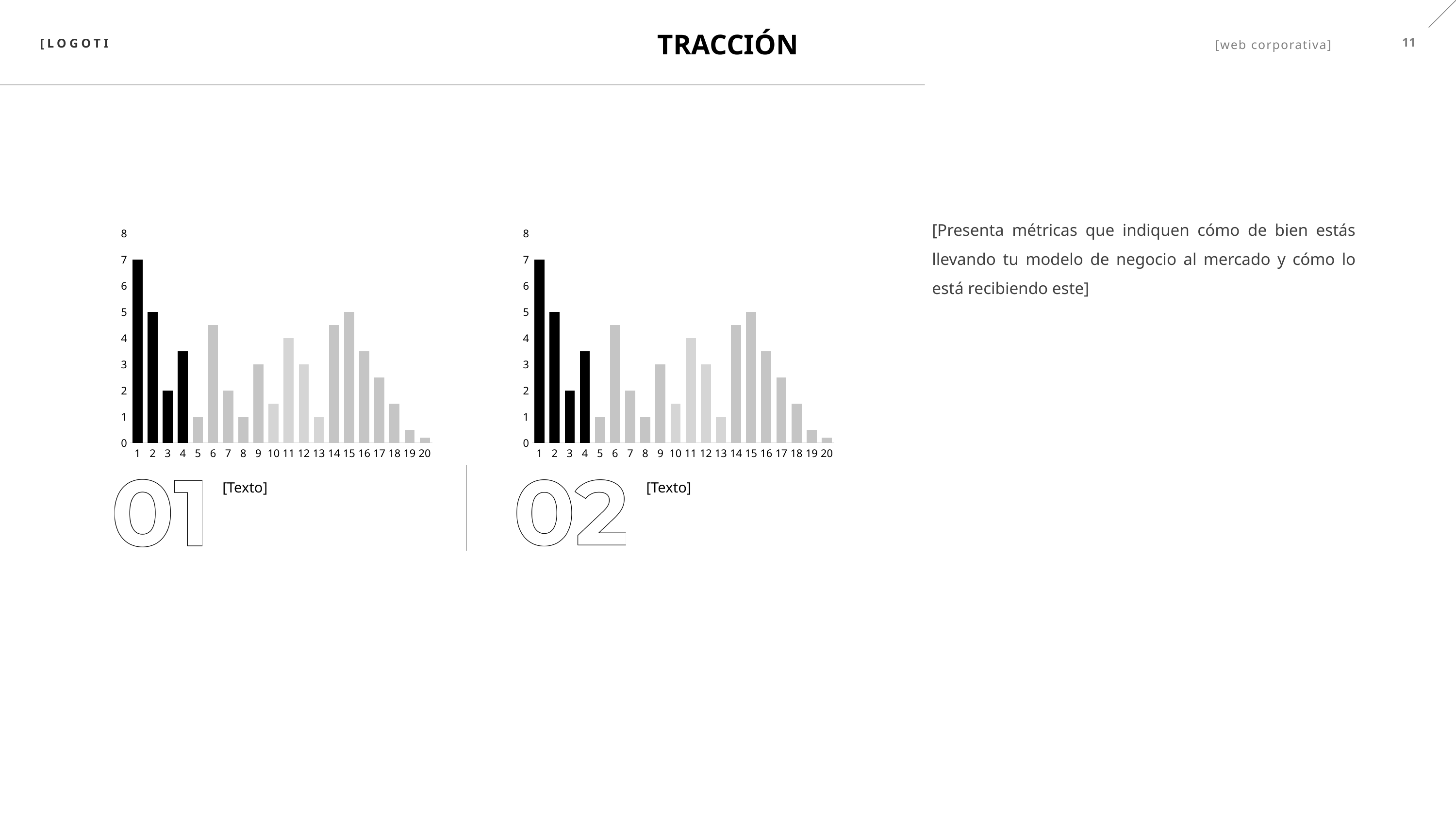
How many categories are shown on the x axis of the left chart? 20 In the right chart, what is the value for category 2? 5 In the left chart, what is the difference between the values for category 1 and category 2? 2 In the left chart, what is the value for category 11? 4 In the right chart, which is larger, the value for category 6 or the value for category 7? category 6 In the right chart, is the value for category 19 greater or less than 1? less In the left chart, which category has the highest value? 1 In the left chart, what is the value for category 1? 7 In the right chart, what is the value for category 9? 3 In the left chart, is the value for category 4 greater or less than 3? greater In the right chart, which category has the lowest value? 20 What kind of chart is the right chart? bar chart